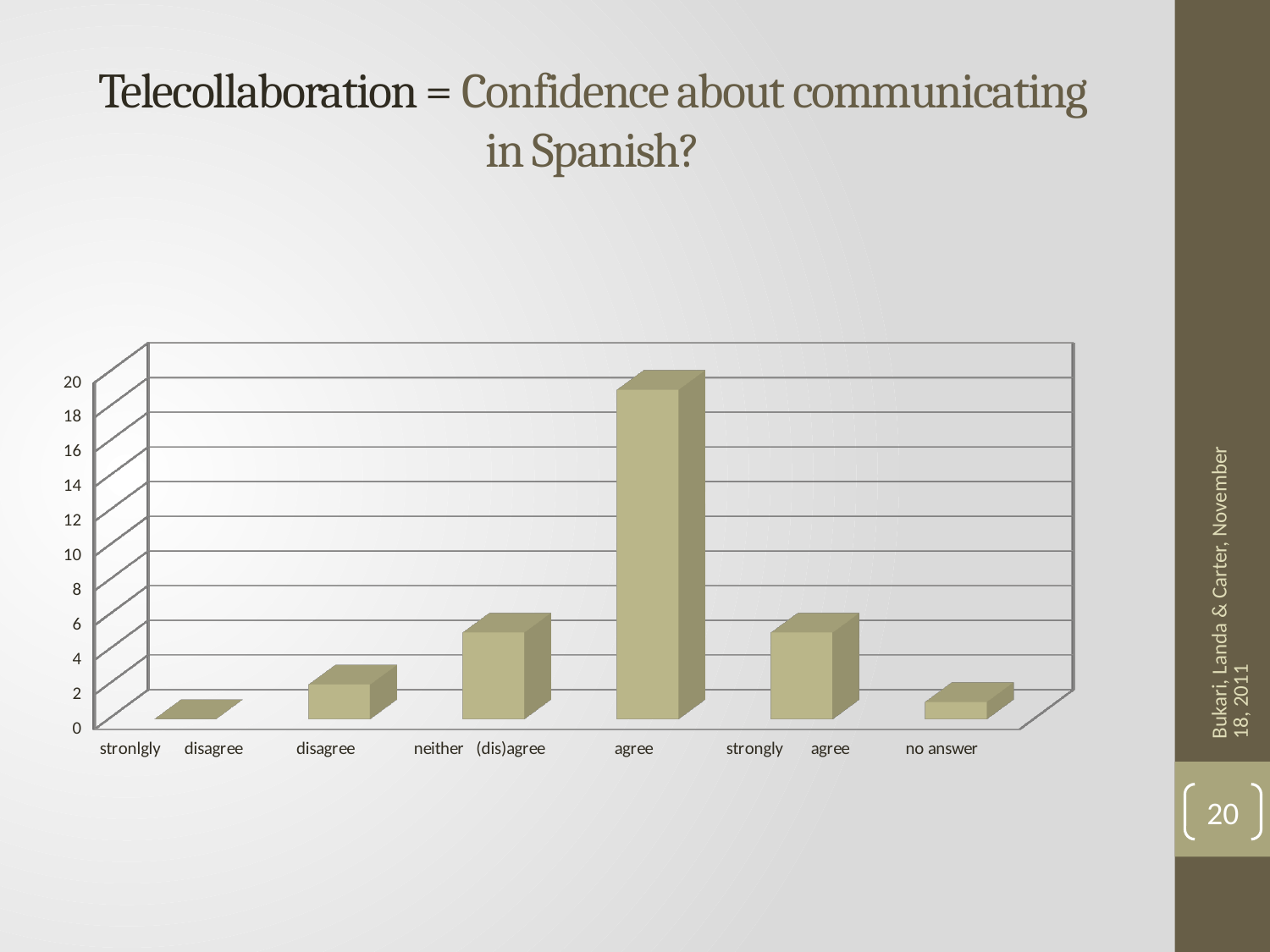
What kind of chart is shown on the slide? bar chart How many response categories are shown on the x axis of the chart? 6 Which is larger, the value for "neither (dis)agree" or the value for "no answer"? neither (dis)agree Which is larger, the value for "agree" or the value for "disagree"? agree Is the value for "agree" greater or less than 10? greater Is the value for "disagree" greater or less than 4? less What is the title of the slide containing the chart? Telecollaboration = Confidence about communicating in Spanish? Is the value for "strongly agree" greater or less than 10? less Which response category has the highest bar in the chart? agree Which response category has the lowest bar in the chart? stronlgly disagree